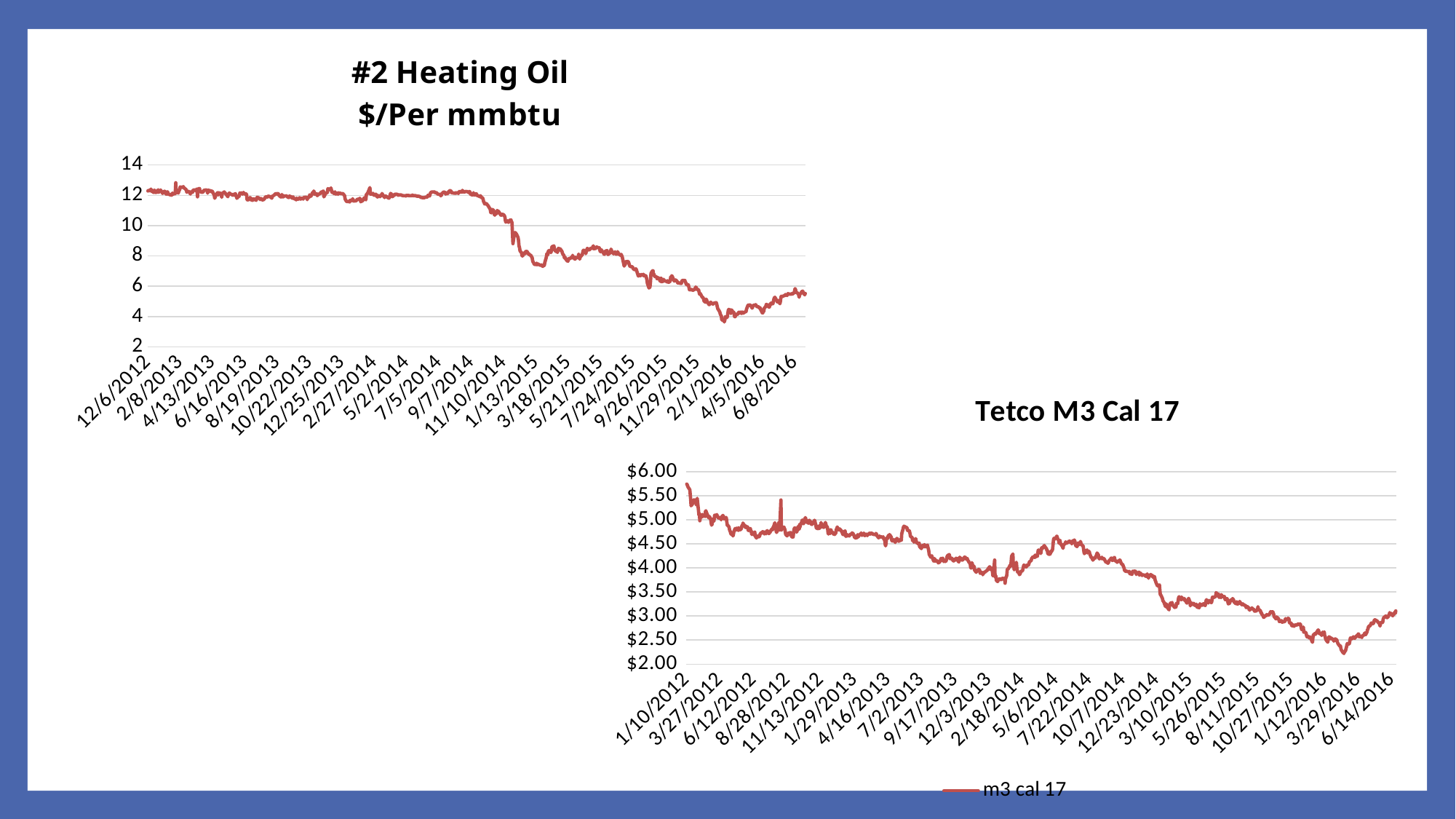
In the "Tetco M3 Cal 17" chart, is the value at 6/14/2016 greater or less than $4.00? less What is the legend entry shown on the "Tetco M3 Cal 17" chart? m3 cal 17 In the "#2 Heating Oil $/Per mmbtu" chart, is the value at 6/8/2016 greater or less than 8? less In the "#2 Heating Oil $/Per mmbtu" chart, do values generally rise or fall from 12/6/2012 to 6/8/2016? fall In the "#2 Heating Oil $/Per mmbtu" chart, is the value at 12/6/2012 greater or less than 10? greater In the "Tetco M3 Cal 17" chart, do values generally rise or fall from 1/10/2012 to 6/14/2016? fall In the "#2 Heating Oil $/Per mmbtu" chart, which is larger, the value at 12/6/2012 or the value at 6/8/2016? 12/6/2012 What kind of chart is the "Tetco M3 Cal 17" chart? line chart What kind of chart is the "#2 Heating Oil $/Per mmbtu" chart? line chart How many series does the legend of the "Tetco M3 Cal 17" chart list? 1